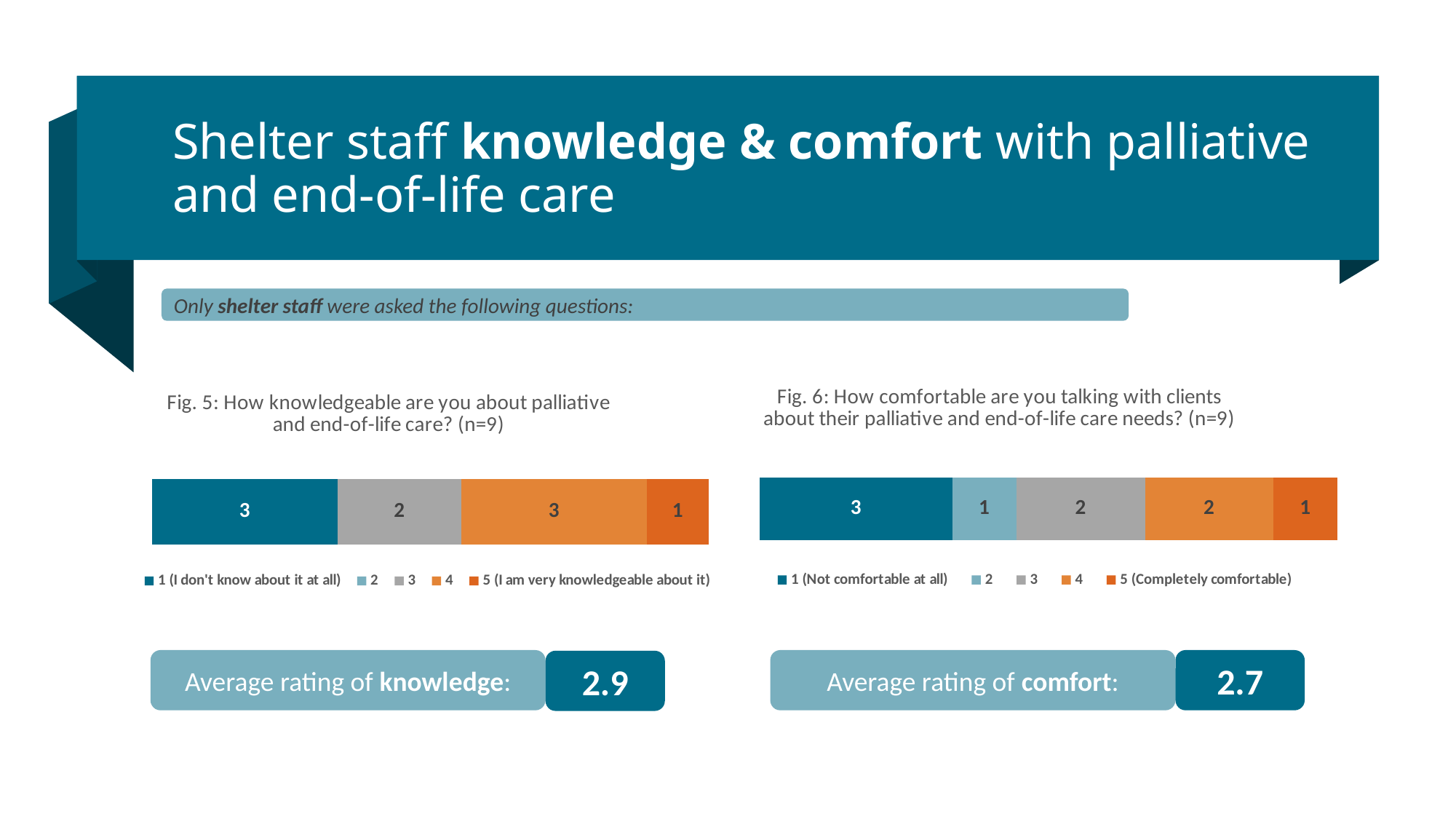
In Fig. 5, how many shelter staff answered 5 (I am very knowledgeable about it)? 1 In Fig. 6, how many shelter staff answered 1 (Not comfortable at all)? 3 How many series does the legend of Fig. 6 list? 5 In Fig. 5, which is larger: the number who answered 3 or the number who answered 4? 4 In Fig. 5, how many shelter staff answered 1 (I don't know about it at all)? 3 What kind of chart is Fig. 5? Stacked bar chart In Fig. 6, what is the total number of responses across all segments of the bar? 9 In Fig. 6, what is the difference between the number who answered 1 (Not comfortable at all) and the number who answered 2? 2 In Fig. 6, how many shelter staff answered 4? 2 In Fig. 5, what is the total number of responses across all segments of the bar? 9 What is the average rating of comfort shown on the slide? 2.7 In Fig. 6, how many shelter staff answered 5 (Completely comfortable)? 1